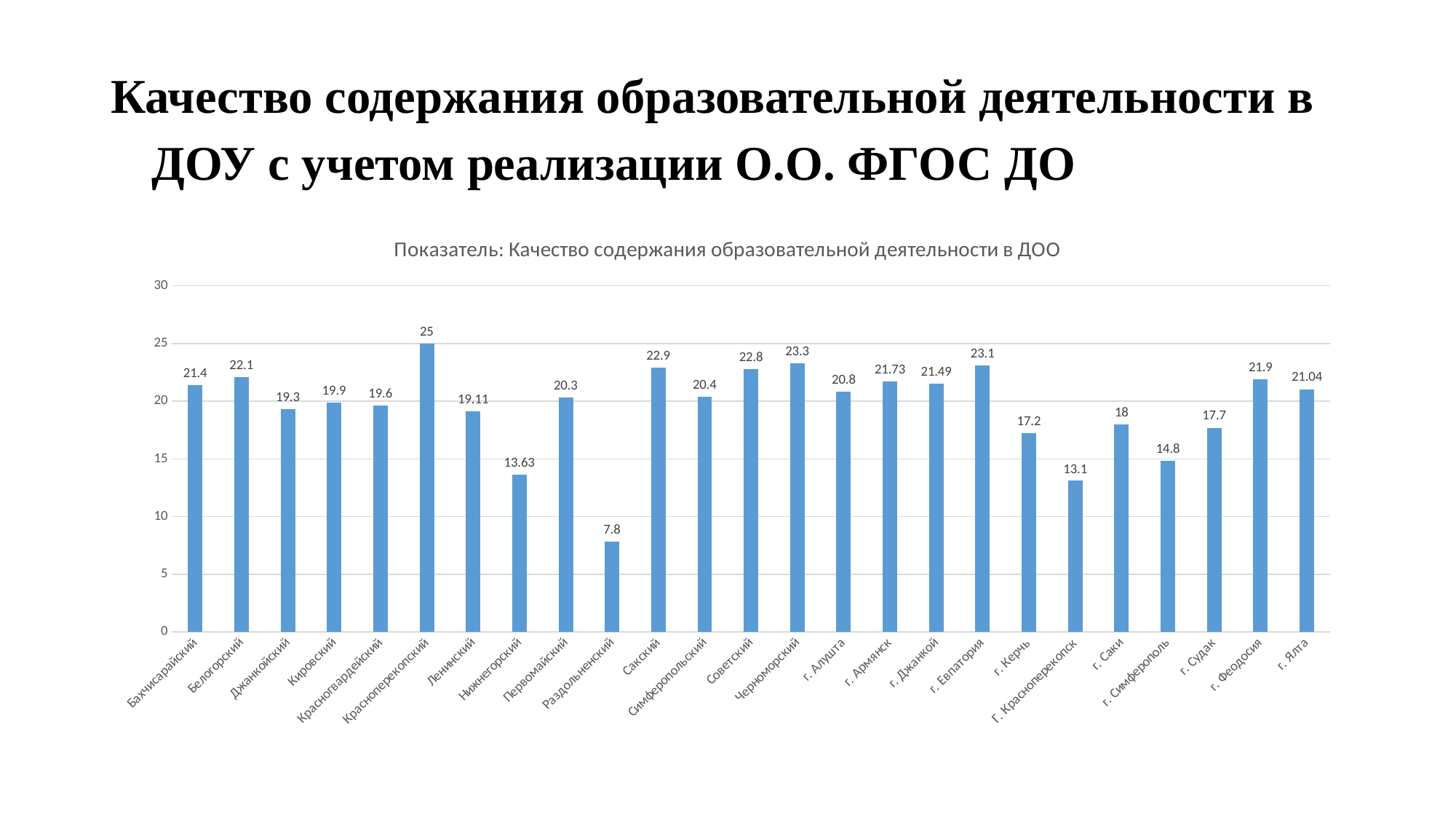
Which category has the highest value? Красноперекопский What is the value for г. Ялта? 21.04 What is the title of the chart? Показатель: Качество содержания образовательной деятельности в ДОО Is the value for г. Симферополь greater or less than 15? less Which category has the lowest value? Раздольненский What kind of chart is shown on the slide? bar chart What is the value for Раздольненский? 7.8 How many categories are shown on the x axis? 25 Which is larger, the value for Сакский or the value for Советский? Сакский What is the value for Красноперекопский? 25 What is the value for Нижнегорский? 13.63 What is the difference between the values for Черноморский and г. Керчь? 6.1